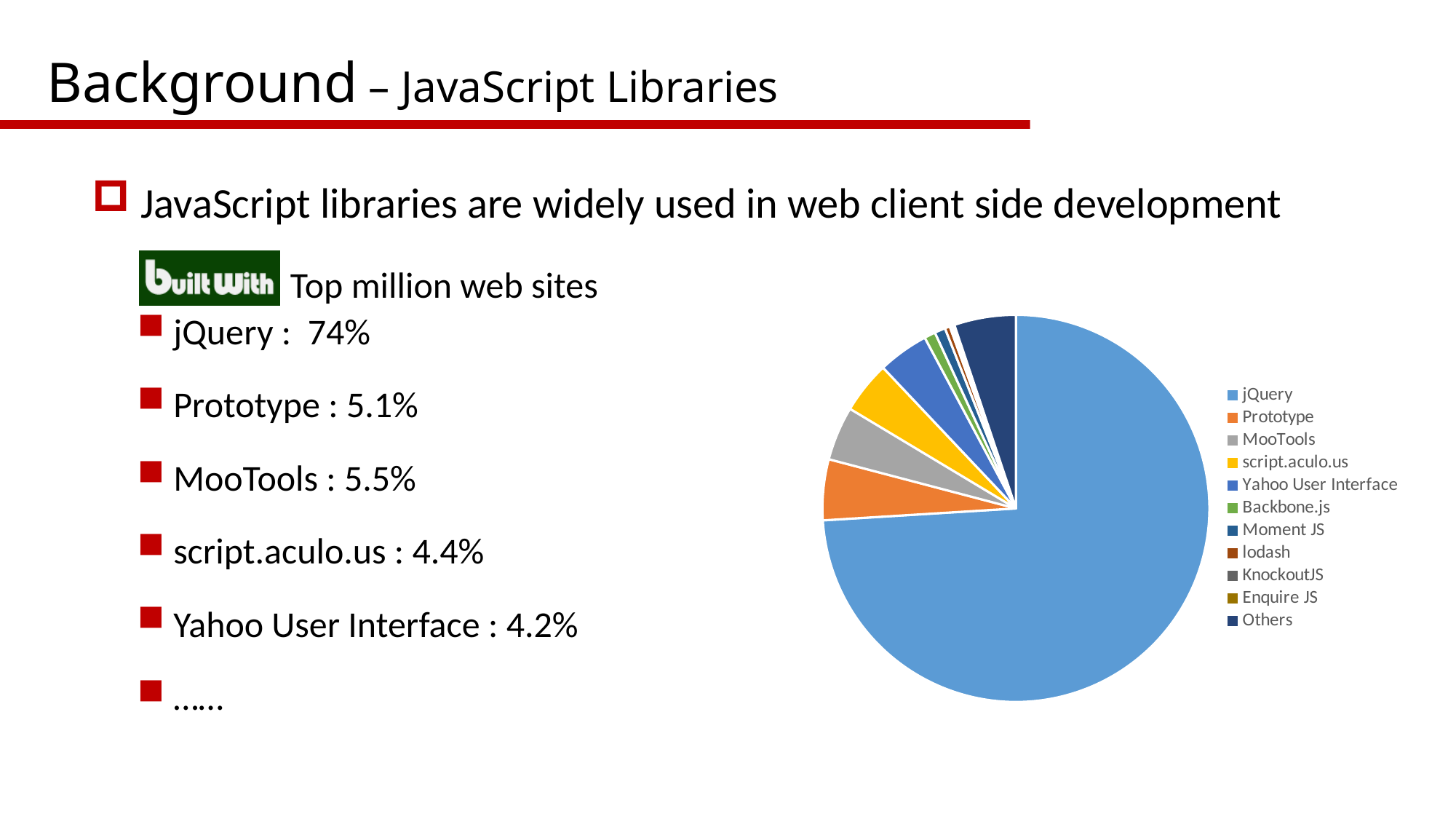
Which slice is larger in the pie chart, jQuery or Prototype? jQuery According to the slide, what share of the top million web sites use Yahoo User Interface? 4.2% What is the difference between the jQuery share and the Prototype share shown on the slide? 68.9% How many entries does the pie chart's legend list? 11 What kind of chart is shown on the slide? pie chart Which slice is larger in the pie chart, MooTools or Backbone.js? MooTools According to the slide, what share of the top million web sites use jQuery? 74% According to the slide, what share of the top million web sites use Prototype? 5.1% According to the slide, what share of the top million web sites use script.aculo.us? 4.4% Which library has the largest slice in the pie chart? jQuery What colour is the jQuery slice in the pie chart? light blue According to the slide, what share of the top million web sites use MooTools? 5.5%